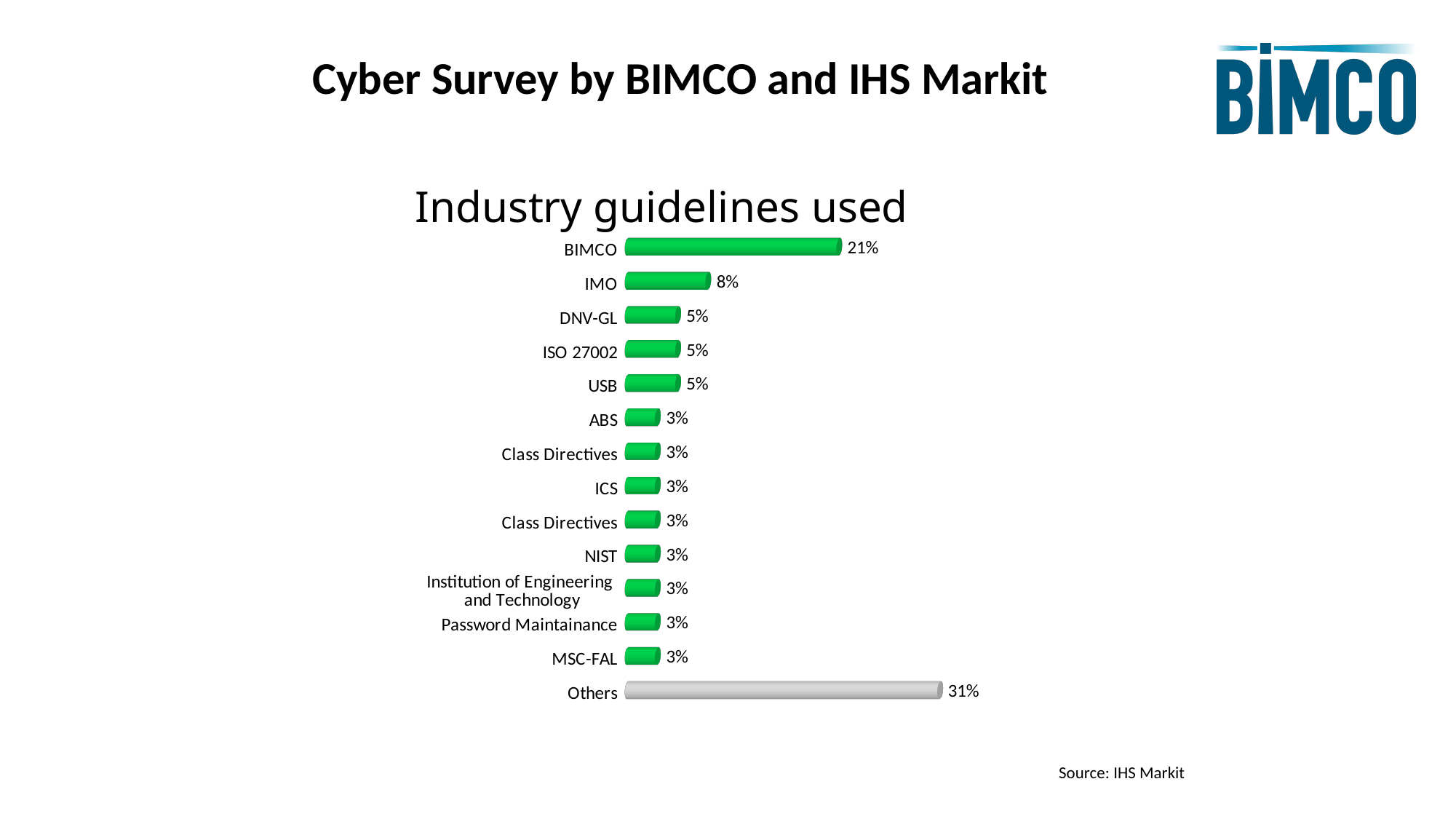
What is the value for IMO? 8% Which category has the highest value? Others What is the value for NIST? 3% What is the difference between the values for Others and BIMCO? 10 percentage points What is the difference between the values for BIMCO and IMO? 13 percentage points How many categories are shown in the chart? 14 What is the title of the chart? Industry guidelines used What is the value for BIMCO in the Industry guidelines used chart? 21% What is the value for Others? 31% What is the value for ISO 27002? 5% What kind of chart is shown on the slide? Bar chart Which is larger, the value for IMO or the value for DNV-GL? IMO